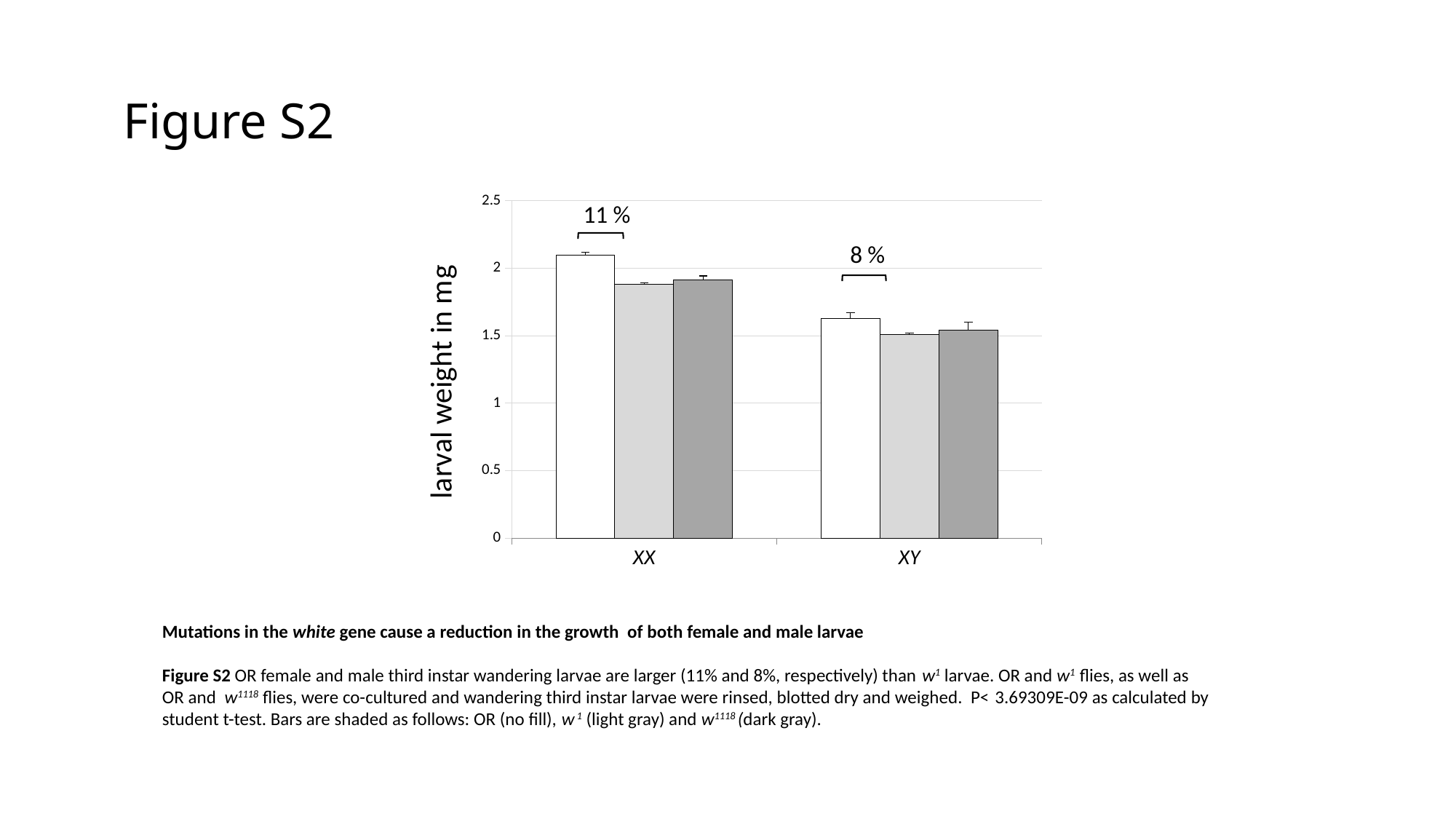
What percentage is annotated above the XX group of bars? 11 % Do the bar values rise or fall going from XX to XY along the x axis? fall What is the label of the y axis of the chart? larval weight in mg How many bars are plotted for each category on the chart? 3 Is the value of the unfilled (OR) bar for XX greater or less than 2? greater Is the value of the dark gray bar for XX greater or less than 2? less How many categories are shown on the x axis of the chart? 2 Which category has the tallest bar on the chart? XX Which is larger, the unfilled (OR) bar for XX or the unfilled (OR) bar for XY? XX Is the value of the light gray bar for XX greater or less than 2? less What kind of chart is shown on the slide? bar chart